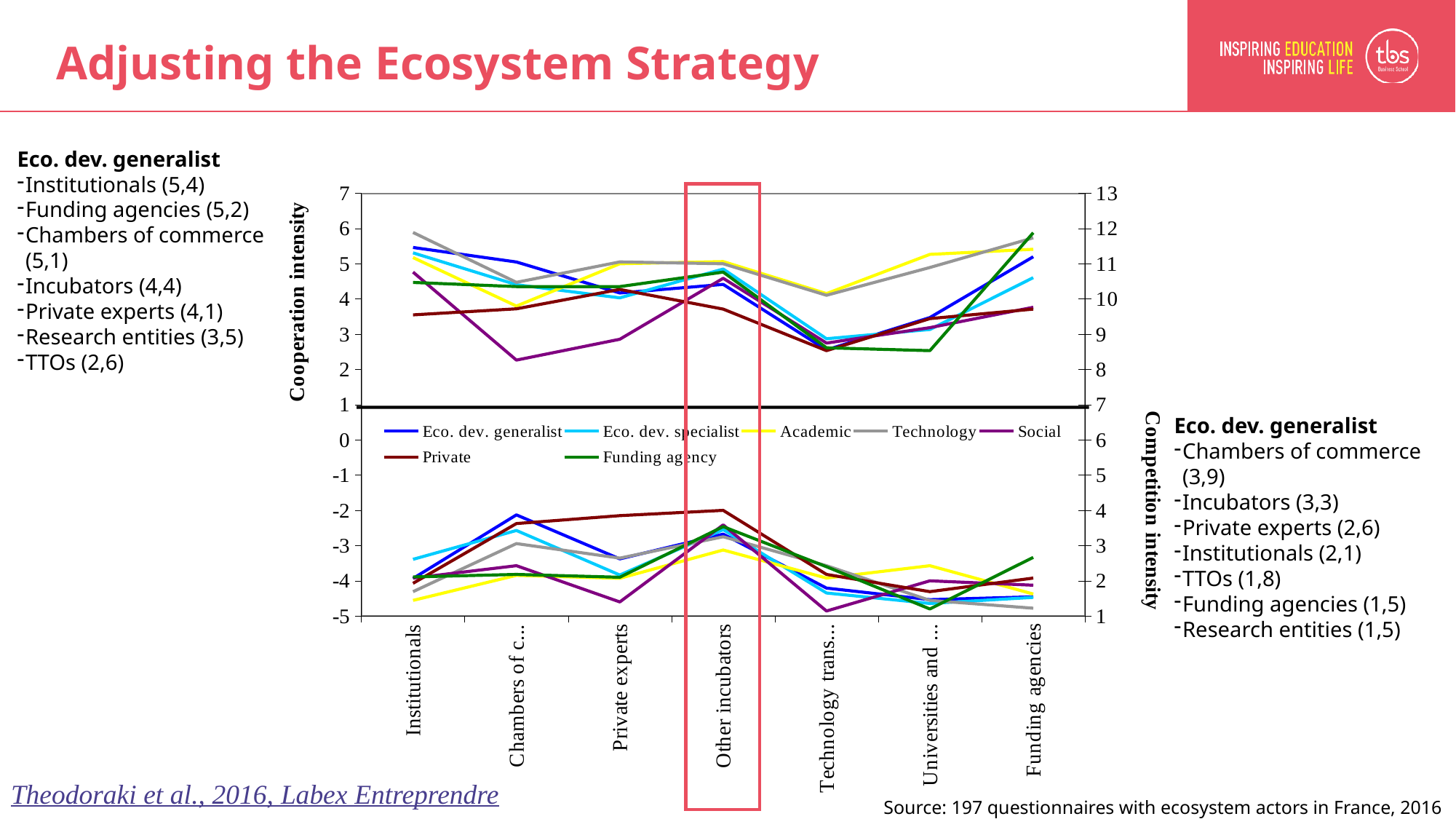
In the upper (cooperation intensity) part of the chart, which series has the highest value at Institutionals? Technology In the upper (cooperation intensity) part of the chart, which series has the lowest value at Chambers of commerce? Social In the upper (cooperation intensity) part of the chart, which series has the lowest value at Institutionals? Private In the upper (cooperation intensity) part of the chart, is the value for Eco. dev. generalist at Institutionals greater or less than 5? greater What kind of chart is shown on the slide? line chart How many categories are shown along the x axis of the chart? 7 How many series does the chart legend list? 7 What is the title of the left vertical axis of the chart? Cooperation intensity In the upper (cooperation intensity) part of the chart, is the value for Social at Chambers of commerce greater or less than 3? less In the upper (cooperation intensity) part of the chart, is the value for Funding agency at Funding agencies greater or less than 5? greater Which x-axis category is highlighted with a red rectangle on the chart? Other incubators